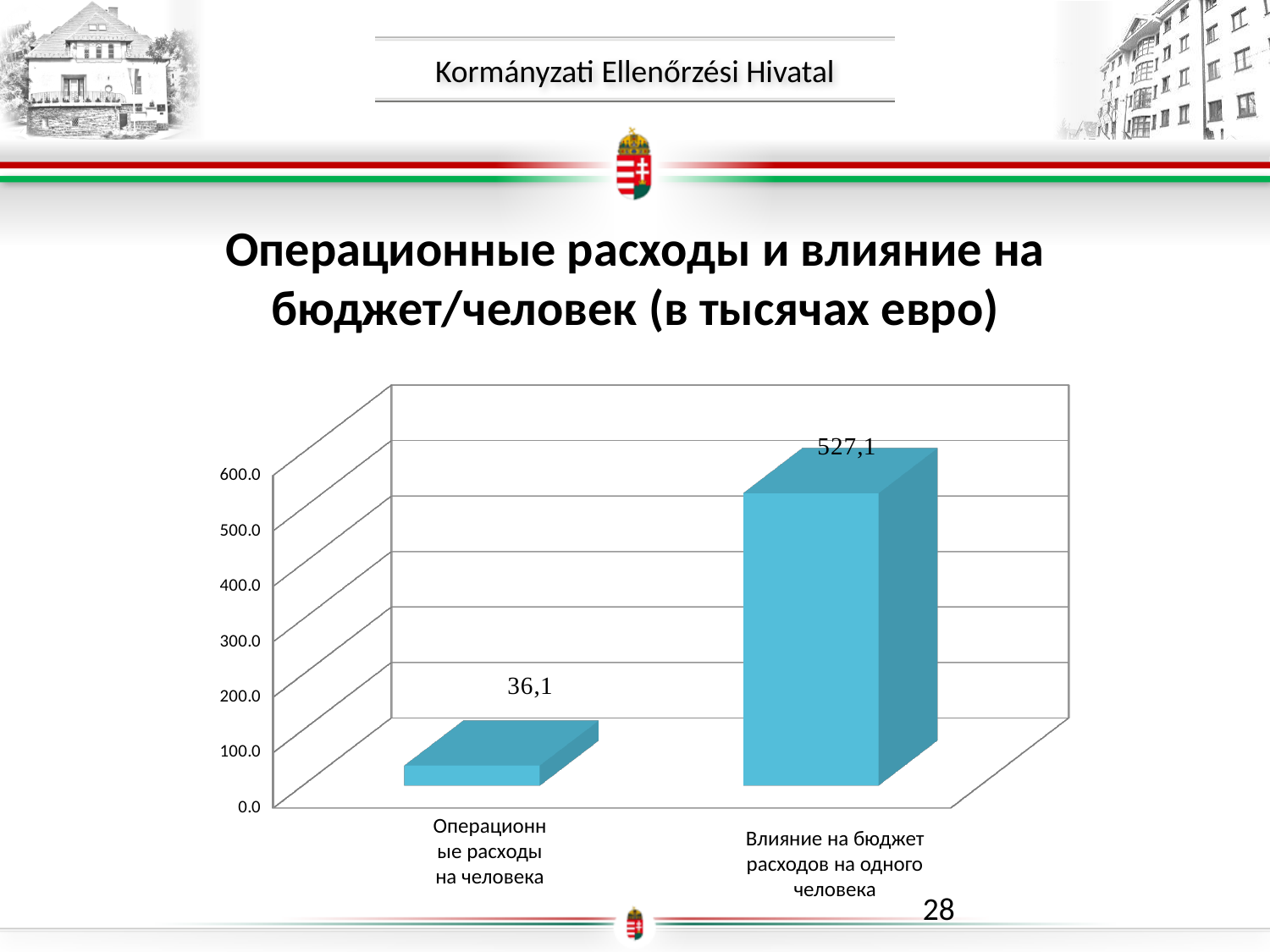
What is the value for Операционные расходы на человека? 36,1 How many categories are shown in the chart? 2 What is the title of the chart on the slide? Операционные расходы и влияние на бюджет/человек (в тысячах евро) Which category has the highest value? Влияние на бюджет расходов на одного человека Is the value for Операционные расходы на человека greater or less than 100? less What is the value for Влияние на бюджет расходов на одного человека? 527,1 What is the difference between the value for Влияние на бюджет расходов на одного человека and the value for Операционные расходы на человека? 491,0 Which is larger: the value for Операционные расходы на человека or the value for Влияние на бюджет расходов на одного человека? Влияние на бюджет расходов на одного человека Is the value for Влияние на бюджет расходов на одного человека greater or less than 500? greater Do the values rise or fall from left to right along the x axis? rise What kind of chart is shown on the slide? bar chart Which category has the lowest value? Операционные расходы на человека